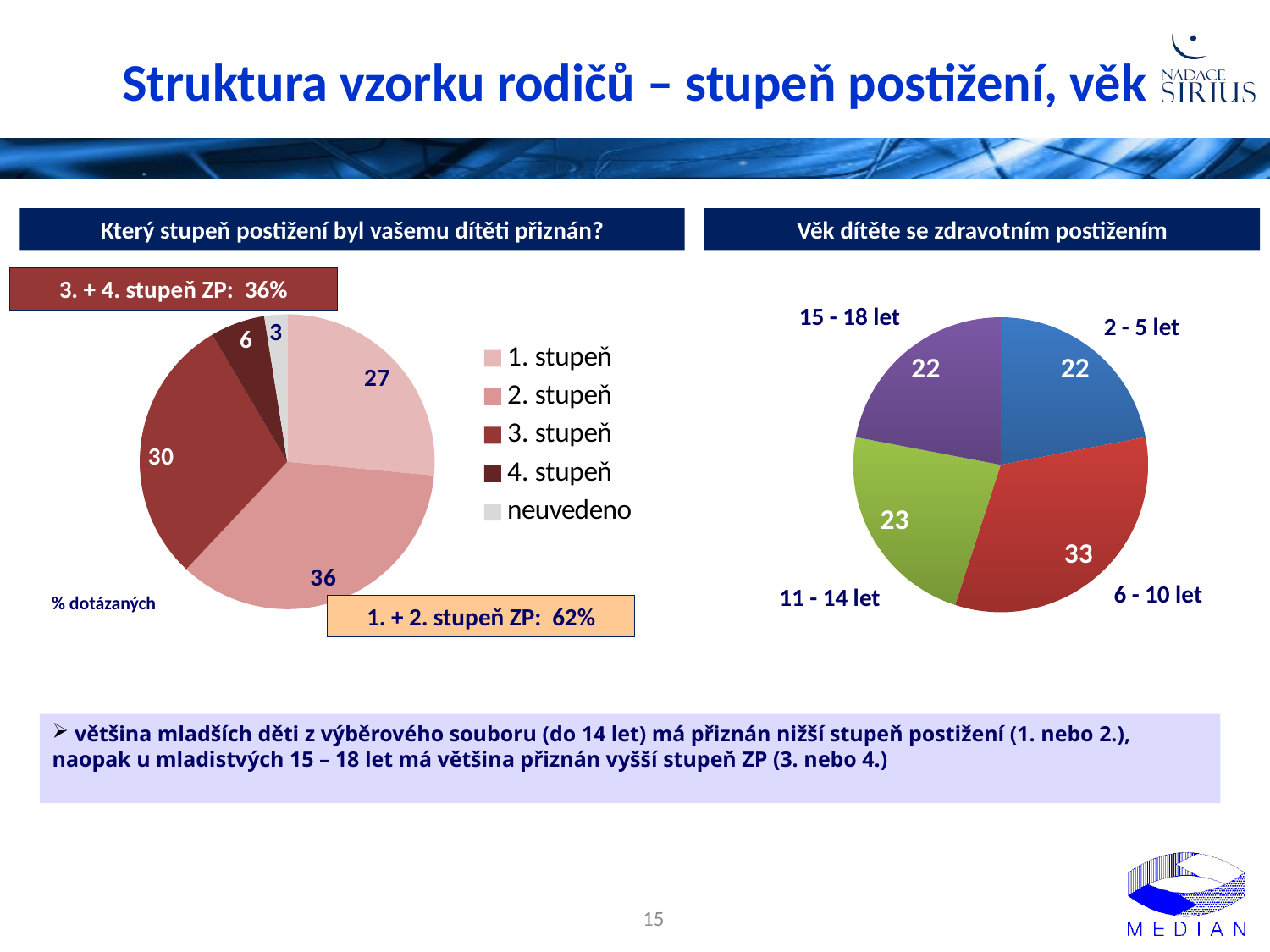
In the right chart (Věk dítěte se zdravotním postižením), which age group has the largest slice? 6 - 10 let In the right chart (Věk dítěte se zdravotním postižením), what is the value for 6 - 10 let? 33 In the right chart (Věk dítěte se zdravotním postižením), what is the value for 11 - 14 let? 23 In the left chart (Který stupeň postižení byl vašemu dítěti přiznán?), which category has the largest slice? 2. stupeň What type of chart is the right chart (Věk dítěte se zdravotním postižením)? Pie chart In the left chart (Který stupeň postižení byl vašemu dítěti přiznán?), what is the difference between the values for 3. stupeň and 1. stupeň? 3 In the right chart (Věk dítěte se zdravotním postižením), how many age groups are shown? 4 In the left chart (Který stupeň postižení byl vašemu dítěti přiznán?), what is the value for 4. stupeň? 6 In the left chart (Který stupeň postižení byl vašemu dítěti přiznán?), what is the value for 2. stupeň? 36 In the right chart (Věk dítěte se zdravotním postižením), which is larger: the value for 6 - 10 let or the value for 11 - 14 let? 6 - 10 let In the left chart (Který stupeň postižení byl vašemu dítěti přiznán?), how many entries does the legend list? 5 In the left chart (Který stupeň postižení byl vašemu dítěti přiznán?), which category has the smallest slice? neuvedeno